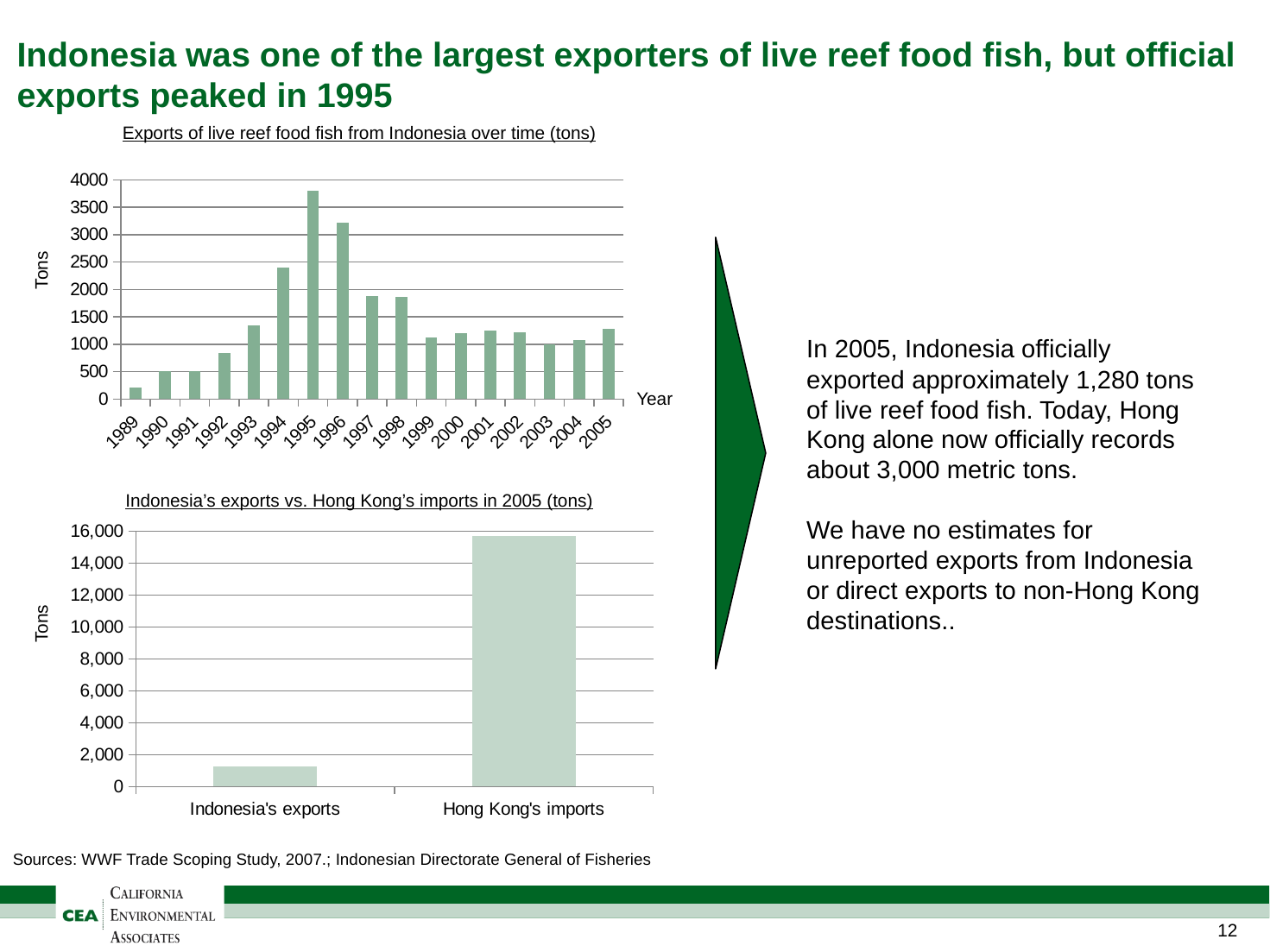
In the bottom chart, 'Indonesia's exports vs. Hong Kong's imports in 2005 (tons)', is the value for Hong Kong's imports greater or less than 14,000? greater In the top chart, 'Exports of live reef food fish from Indonesia over time (tons)', what is the label on the vertical axis? Tons In the top chart, 'Exports of live reef food fish from Indonesia over time (tons)', do exports rise or fall from 1995 to 1999? fall In the top chart, 'Exports of live reef food fish from Indonesia over time (tons)', is the value for 1989 greater or less than 500? less What kind of chart is the bottom chart, 'Indonesia's exports vs. Hong Kong's imports in 2005 (tons)'? bar chart In the top chart, 'Exports of live reef food fish from Indonesia over time (tons)', which year has higher exports, 1994 or 1996? 1996 In the top chart, 'Exports of live reef food fish from Indonesia over time (tons)', how many years are shown on the x axis? 17 In the top chart, 'Exports of live reef food fish from Indonesia over time (tons)', is the value for 1995 greater or less than 3500? greater In the top chart, 'Exports of live reef food fish from Indonesia over time (tons)', which year has the lowest exports? 1989 What kind of chart is the top chart, 'Exports of live reef food fish from Indonesia over time (tons)'? bar chart In the bottom chart, 'Indonesia's exports vs. Hong Kong's imports in 2005 (tons)', which category has the larger value? Hong Kong's imports In the top chart, 'Exports of live reef food fish from Indonesia over time (tons)', which year has the highest exports? 1995